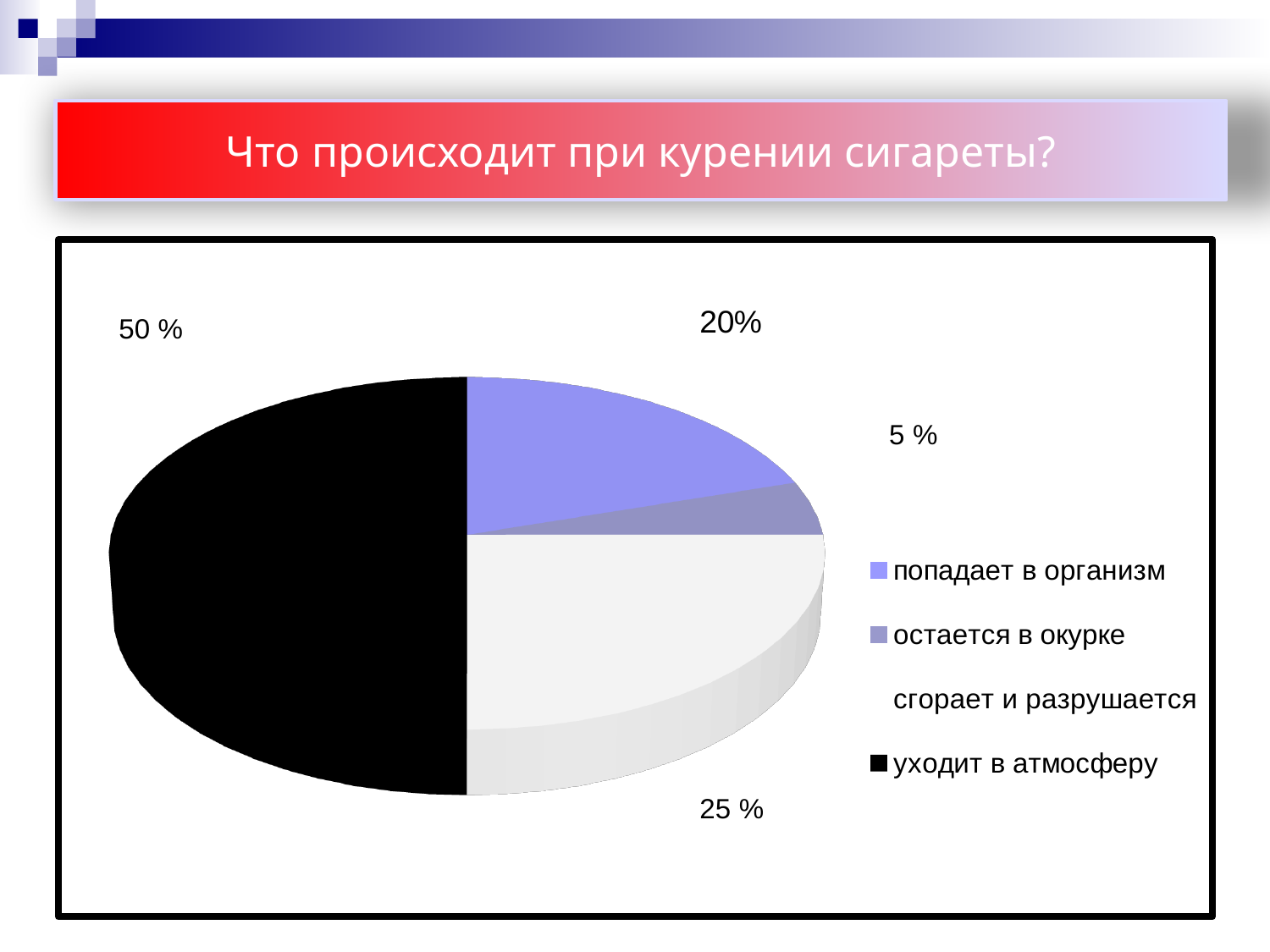
Which category has the largest slice of the pie? уходит в атмосферу What is the title of the slide above the chart? Что происходит при курении сигареты? What is the value for "уходит в атмосферу"? 50 % What is the difference between the values for "уходит в атмосферу" and "сгорает и разрушается"? 25 % What is the value for "попадает в организм"? 20% How many entries does the legend list? 4 What kind of chart is shown on the slide? pie chart What is the value for "остается в окурке"? 5 % How many slices does the pie chart have? 4 Which is larger, "сгорает и разрушается" or "попадает в организм"? сгорает и разрушается What is the value for "сгорает и разрушается"? 25 % Which category has the smallest slice of the pie? остается в окурке